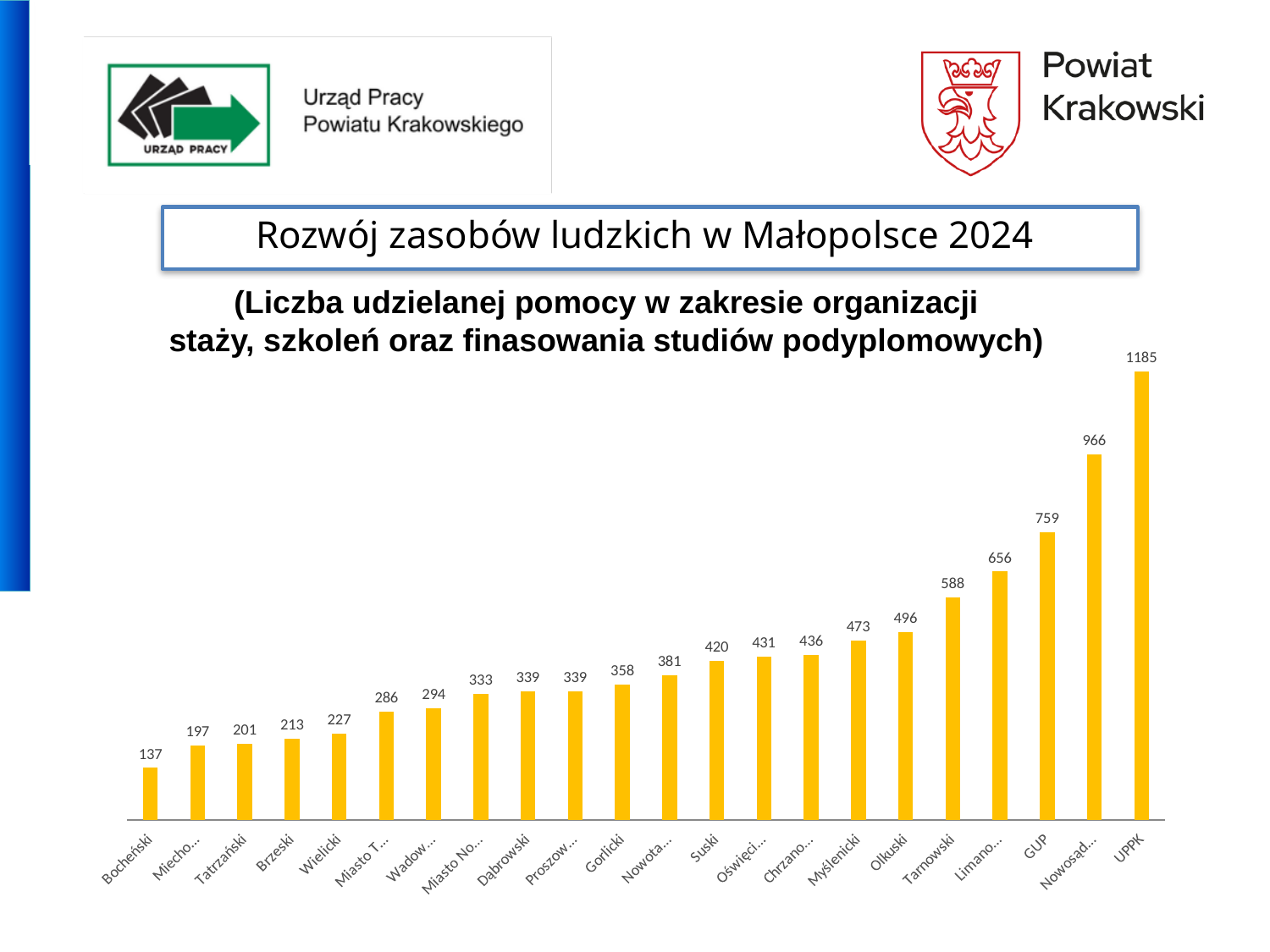
Which category has the highest value? UPPK What is the value for Myślenicki? 473 What is the value for Bocheński? 137 Which category has the lowest value? Bocheński What kind of chart is shown on the slide? Bar chart How many bars are shown in the chart? 22 What is the value for UPPK? 1185 Do the values rise or fall from left to right along the x axis? Rise What is the difference between the values for Olkuski and Suski? 76 What is the value for GUP? 759 What is the difference between the values for UPPK and GUP? 426 Which is larger, the value for Tarnowski or the value for Olkuski? Tarnowski